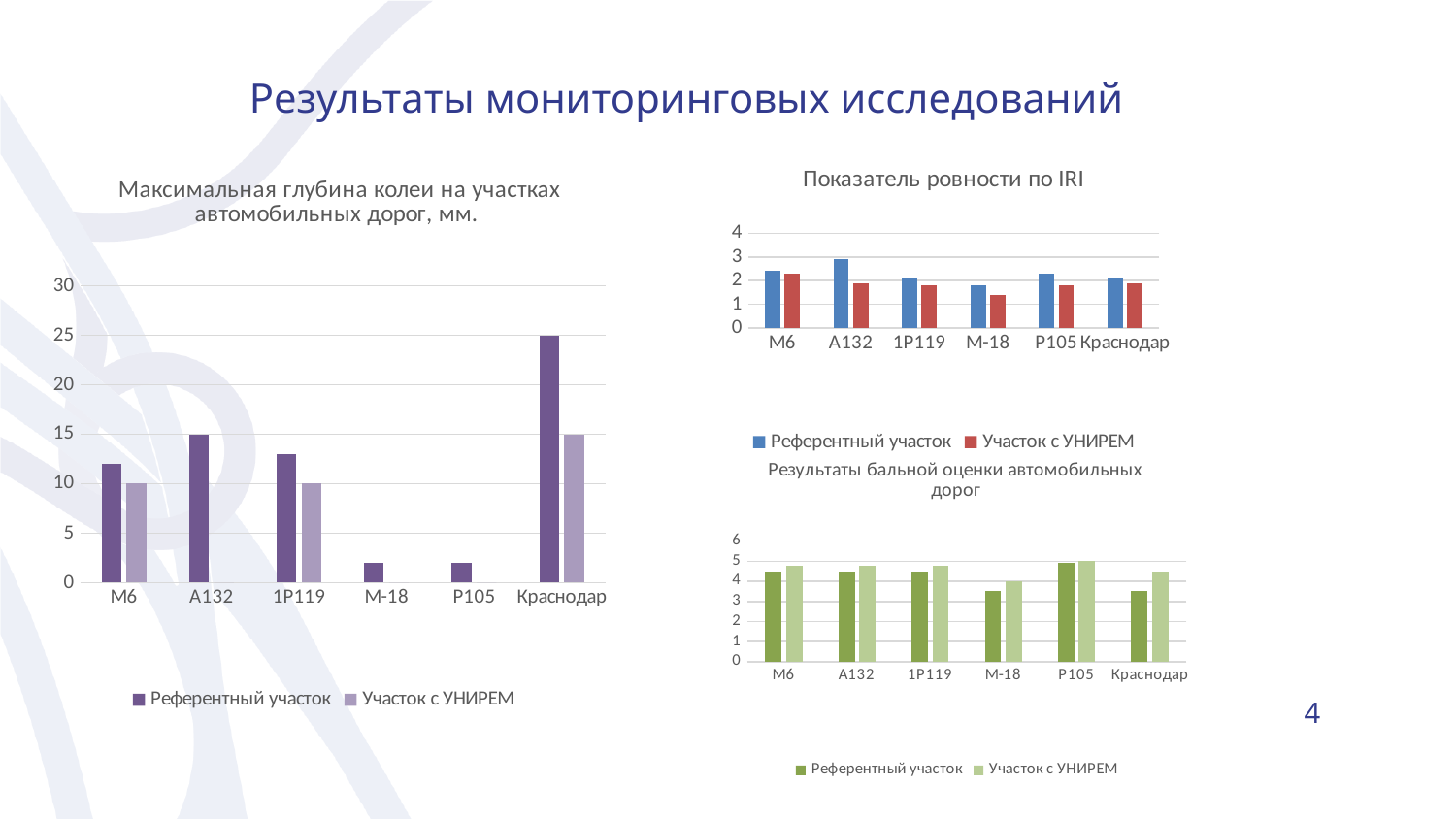
In the chart 'Результаты бальной оценки автомобильных дорог', which is larger for М-18: the 'Референтный участок' value or the 'Участок с УНИРЕМ' value? Участок с УНИРЕМ In the chart 'Максимальная глубина колеи на участках автомобильных дорог, мм.', what is the difference between the 'Референтный участок' and 'Участок с УНИРЕМ' values for Краснодар? 10 How many categories are shown on the x axis of the chart 'Показатель ровности по IRI'? 6 In the chart 'Максимальная глубина колеи на участках автомобильных дорог, мм.', is the 'Референтный участок' value for М6 greater or less than 10? greater In the chart 'Показатель ровности по IRI', is the 'Участок с УНИРЕМ' value for М-18 greater or less than 2? less In the chart 'Максимальная глубина колеи на участках автомобильных дорог, мм.', what is the value for Краснодар in the 'Референтный участок' series? 25 What type of chart is 'Результаты бальной оценки автомобильных дорог'? bar chart In the chart 'Максимальная глубина колеи на участках автомобильных дорог, мм.', what is the value for Краснодар in the 'Участок с УНИРЕМ' series? 15 In the chart 'Результаты бальной оценки автомобильных дорог', is the 'Референтный участок' value for Краснодар greater or less than 4? less In the chart 'Максимальная глубина колеи на участках автомобильных дорог, мм.', what is the value for А132 in the 'Референтный участок' series? 15 In the chart 'Показатель ровности по IRI', which category has the highest value in the 'Референтный участок' series? А132 In the chart 'Максимальная глубина колеи на участках автомобильных дорог, мм.', which category has the highest value in the 'Референтный участок' series? Краснодар